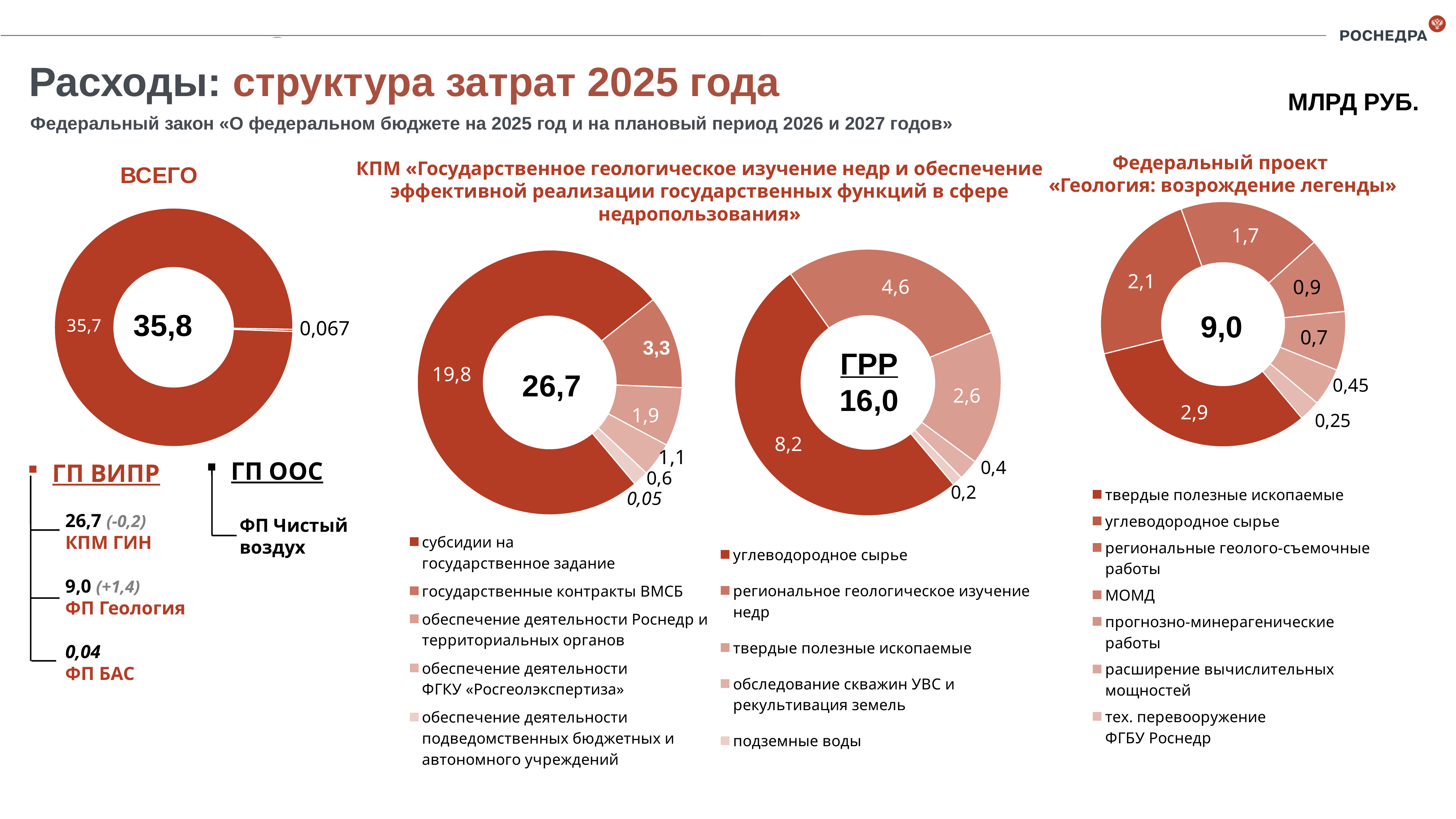
On the ГРР chart, which category has the largest value? углеводородное сырье On the КПМ «Государственное геологическое изучение недр...» chart, what is the difference between субсидии на государственное задание and государственные контракты ВМСБ? 16,5 On the "ВСЕГО" chart, what is the value of the ГП ООС segment? 0,067 On the КПМ «Государственное геологическое изучение недр...» chart, what is the value for субсидии на государственное задание? 19,8 On the Федеральный проект «Геология: возрождение легенды» chart, how many categories does the legend list? 7 On the "ВСЕГО" chart, what is the value of the ГП ВИПР segment? 35,7 What type of chart is used for the ГРР breakdown? Donut (pie) chart On the "ВСЕГО" chart, what total value is shown in the centre of the donut? 35,8 On the КПМ «Государственное геологическое изучение недр...» chart, what is the value for государственные контракты ВМСБ? 3,3 On the Федеральный проект «Геология: возрождение легенды» chart, what is the value for твердые полезные ископаемые? 2,9 On the ГРР chart, what is the value for углеводородное сырье? 8,2 On the ГРР chart, which is larger: региональное геологическое изучение недр or твердые полезные ископаемые? региональное геологическое изучение недр